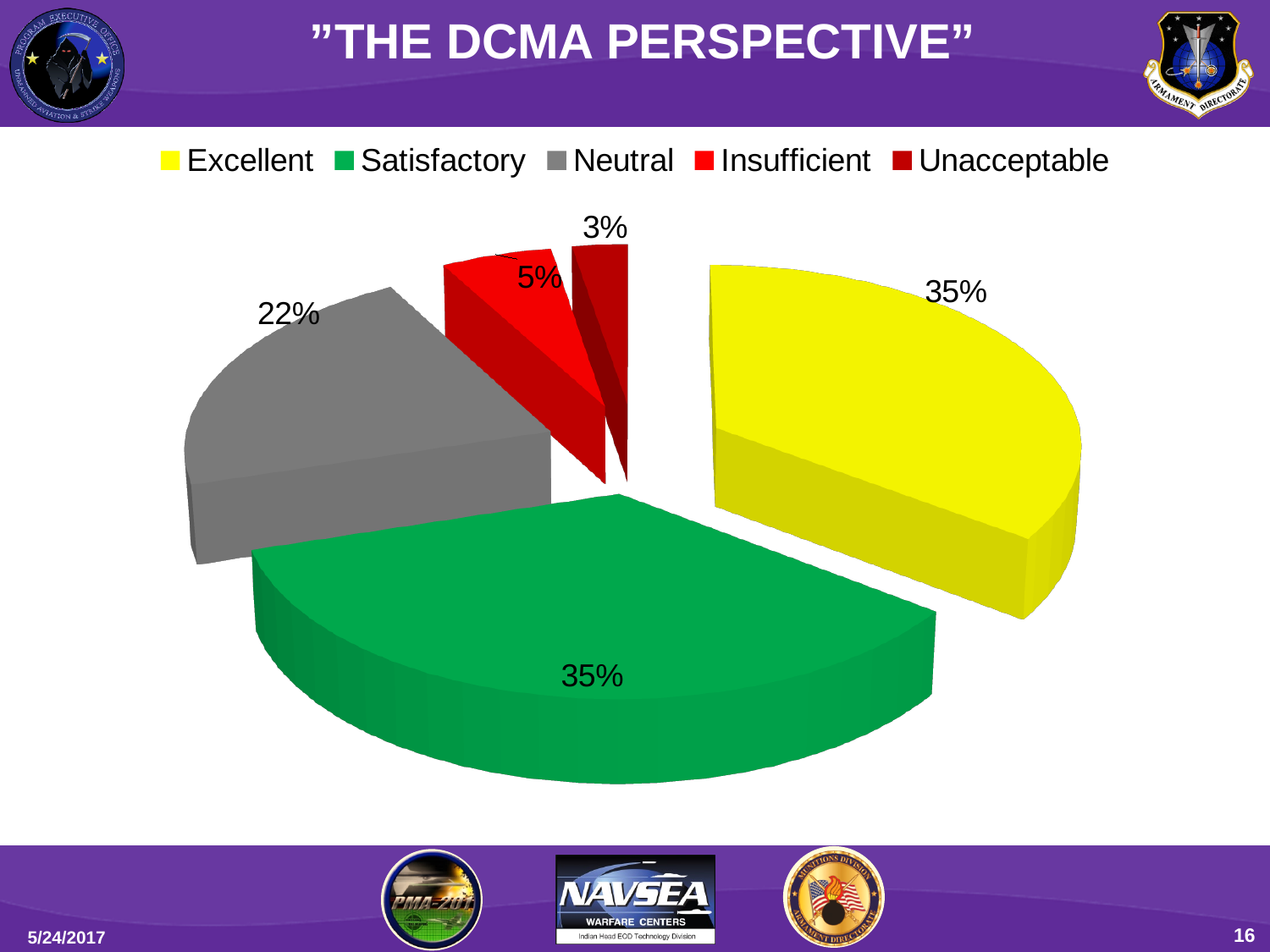
How many categories does the legend list? 5 Which category has the smallest slice of the pie? Unacceptable What kind of chart is shown on the slide? pie chart What is the difference in percentage points between the Neutral slice and the Insufficient slice? 17 What percentage of the pie is labelled Neutral? 22% What percentage of the pie is labelled Unacceptable? 3% Which slice is larger, Neutral or Insufficient? Neutral What colour is the Satisfactory slice? green What percentage of the pie is labelled Excellent? 35% What is the title of the slide containing the chart? "THE DCMA PERSPECTIVE" What percentage of the pie is labelled Satisfactory? 35% What percentage of the pie is labelled Insufficient? 5%